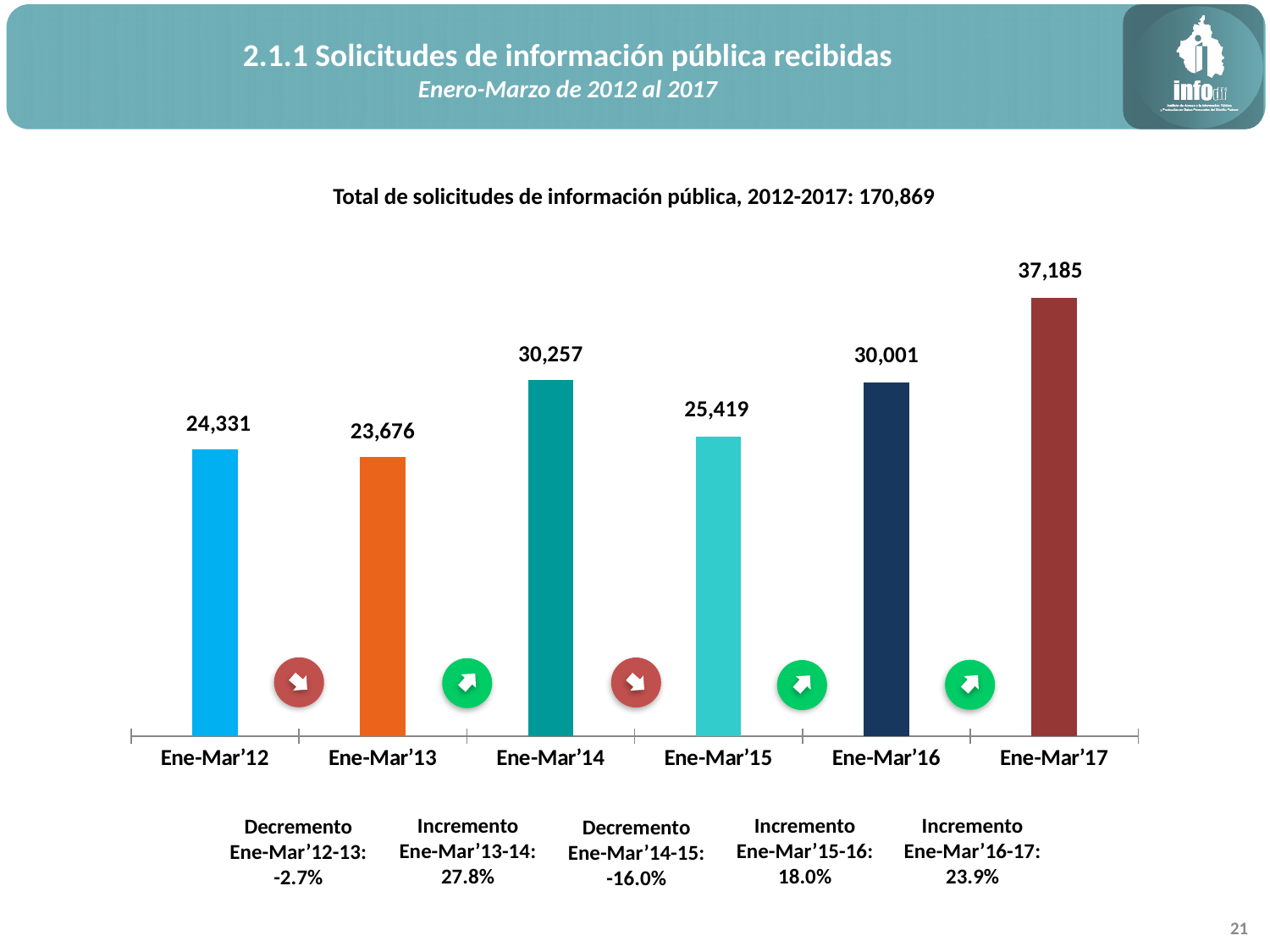
How many periods are shown on the chart? 6 Which period has the lowest value? Ene-Mar'13 What is the value for Ene-Mar'12? 24,331 What is the value for Ene-Mar'17? 37,185 What is the difference between the values for Ene-Mar'14 and Ene-Mar'15? 4,838 Which is larger, the value for Ene-Mar'14 or the value for Ene-Mar'16? Ene-Mar'14 What is the value for Ene-Mar'15? 25,419 What kind of chart is shown on the slide? Bar chart What percentage change is shown between Ene-Mar'13 and Ene-Mar'14? 27.8% Which period has the highest value? Ene-Mar'17 What is the total of solicitudes de información pública for 2012-2017 stated above the chart? 170,869 What is the difference between the values for Ene-Mar'17 and Ene-Mar'16? 7,184